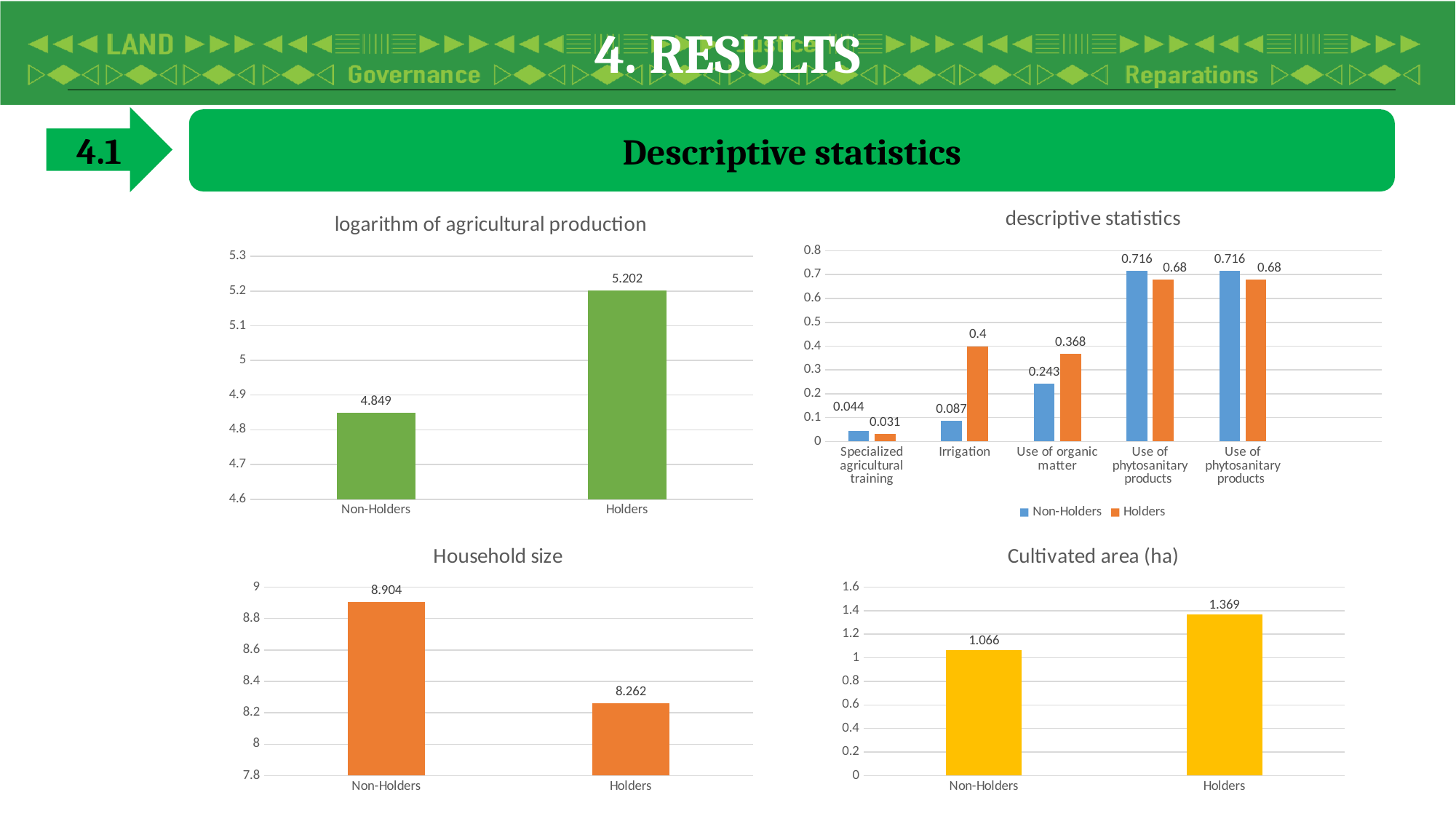
In the 'descriptive statistics' chart, which category has the lowest Holders value? Specialized agricultural training In the 'descriptive statistics' chart, what is the Holders value for Irrigation? 0.4 In the 'Household size' chart, which category has the higher value, Non-Holders or Holders? Non-Holders In the 'Cultivated area (ha)' chart, what is the difference between the Holders and Non-Holders values? 0.303 In the 'logarithm of agricultural production' chart, what is the difference between the Holders and Non-Holders values? 0.353 In the 'descriptive statistics' chart, how many series does the legend list? 2 In the 'descriptive statistics' chart, what is the difference between the Holders and Non-Holders values for Irrigation? 0.313 In the 'logarithm of agricultural production' chart, what is the value for Holders? 5.202 In the 'Household size' chart, what is the value for Holders? 8.262 In the 'Cultivated area (ha)' chart, what is the value for Non-Holders? 1.066 In the 'descriptive statistics' chart, what is the Non-Holders value for Use of organic matter? 0.243 What kind of chart is the 'Cultivated area (ha)' chart? Bar chart